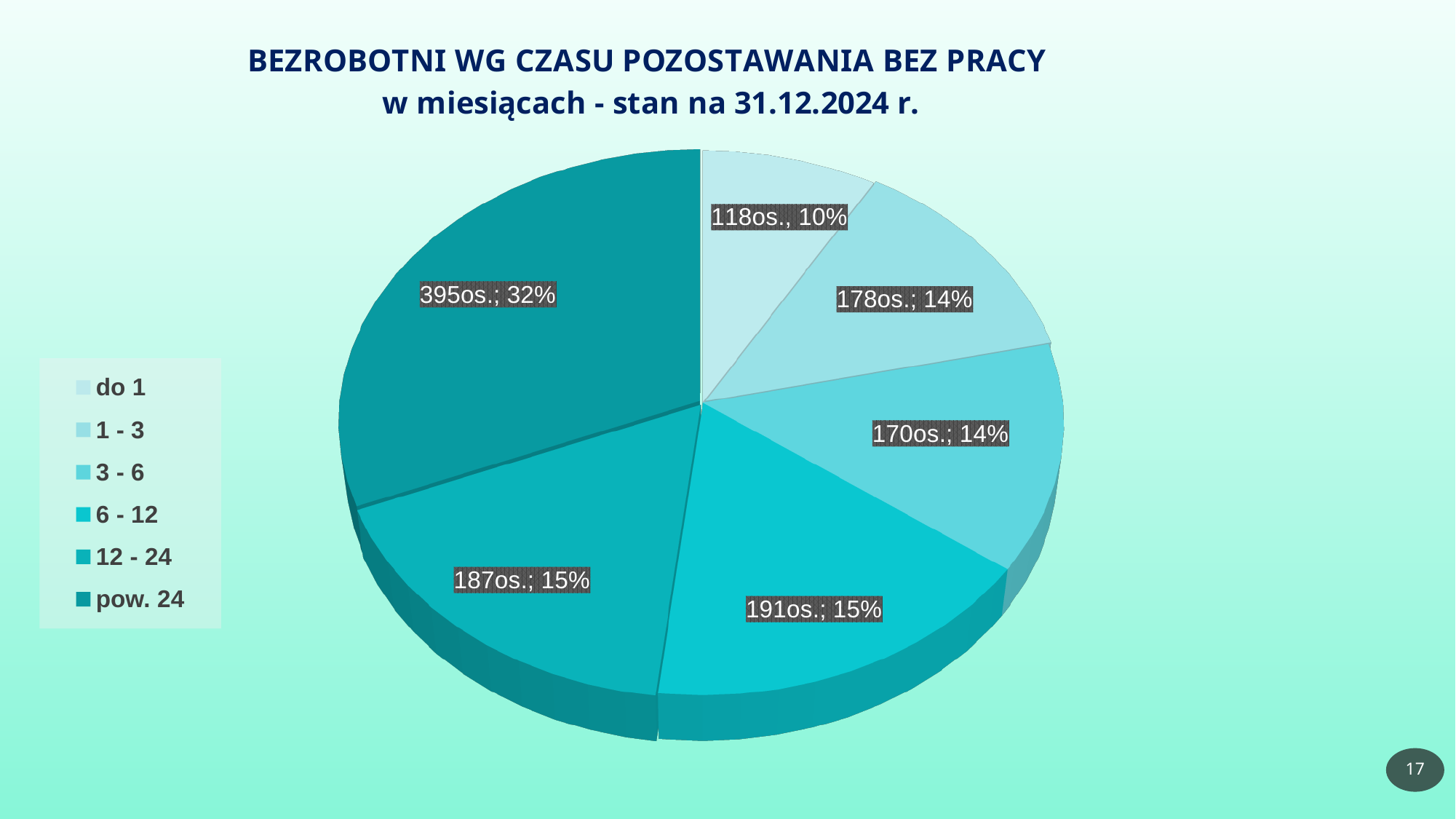
What share of the pie does the '1 - 3' category represent? 14% What share of the pie does the 'pow. 24' category represent? 32% How many people are in the 'pow. 24' category? 395os. What is the difference in number of people between the 'pow. 24' and 'do 1' categories? 277 How many entries does the legend list? 6 Which category has more people, '6 - 12' or '12 - 24'? 6 - 12 How many people are in the '6 - 12' category? 191os. How many people are in the 'do 1' category? 118os. Which category has the largest slice? pow. 24 How many slices does the pie chart have? 6 Which category has the smallest slice? do 1 What kind of chart is shown on the slide? pie chart